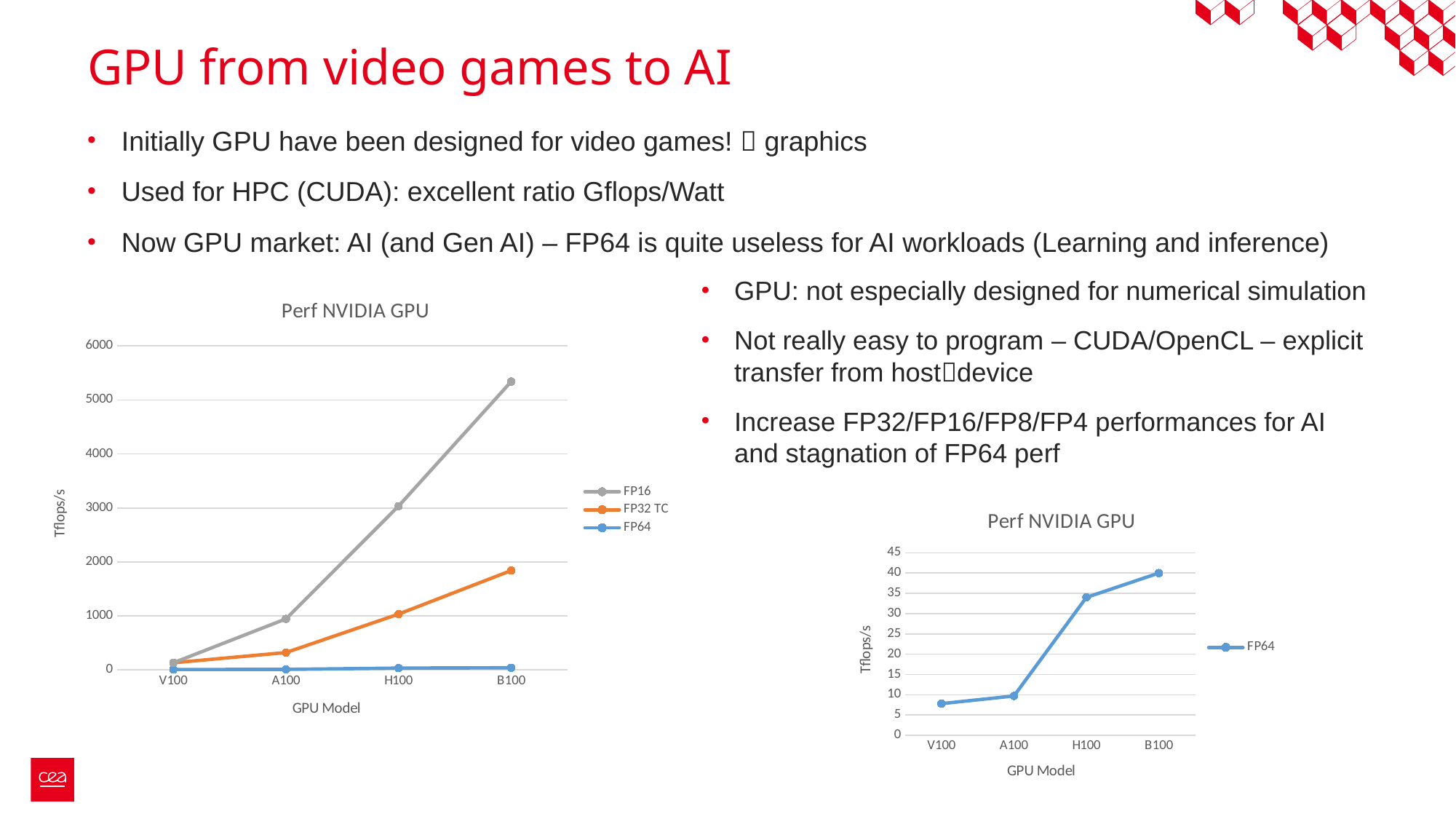
How many GPU models are shown on the x axis of the left chart? 4 In the left chart, is the FP32 TC value for B100 greater or less than 2000? less What kind of chart is the left chart on the slide? line chart In the left chart, is the FP16 value for B100 greater or less than 5000? greater How many series does the legend of the right chart list? 1 In the right chart, which has the larger FP64 value, V100 or H100? H100 In the right chart, is the FP64 value for H100 greater or less than 30? greater In the left chart, which series has the highest value at B100? FP16 How many series does the legend of the left chart list? 3 In the left chart, does the FP16 series rise or fall from V100 to B100? rises What are the legend entries of the left chart? FP16, FP32 TC, FP64 In the right chart, which GPU model has the highest FP64 value? B100